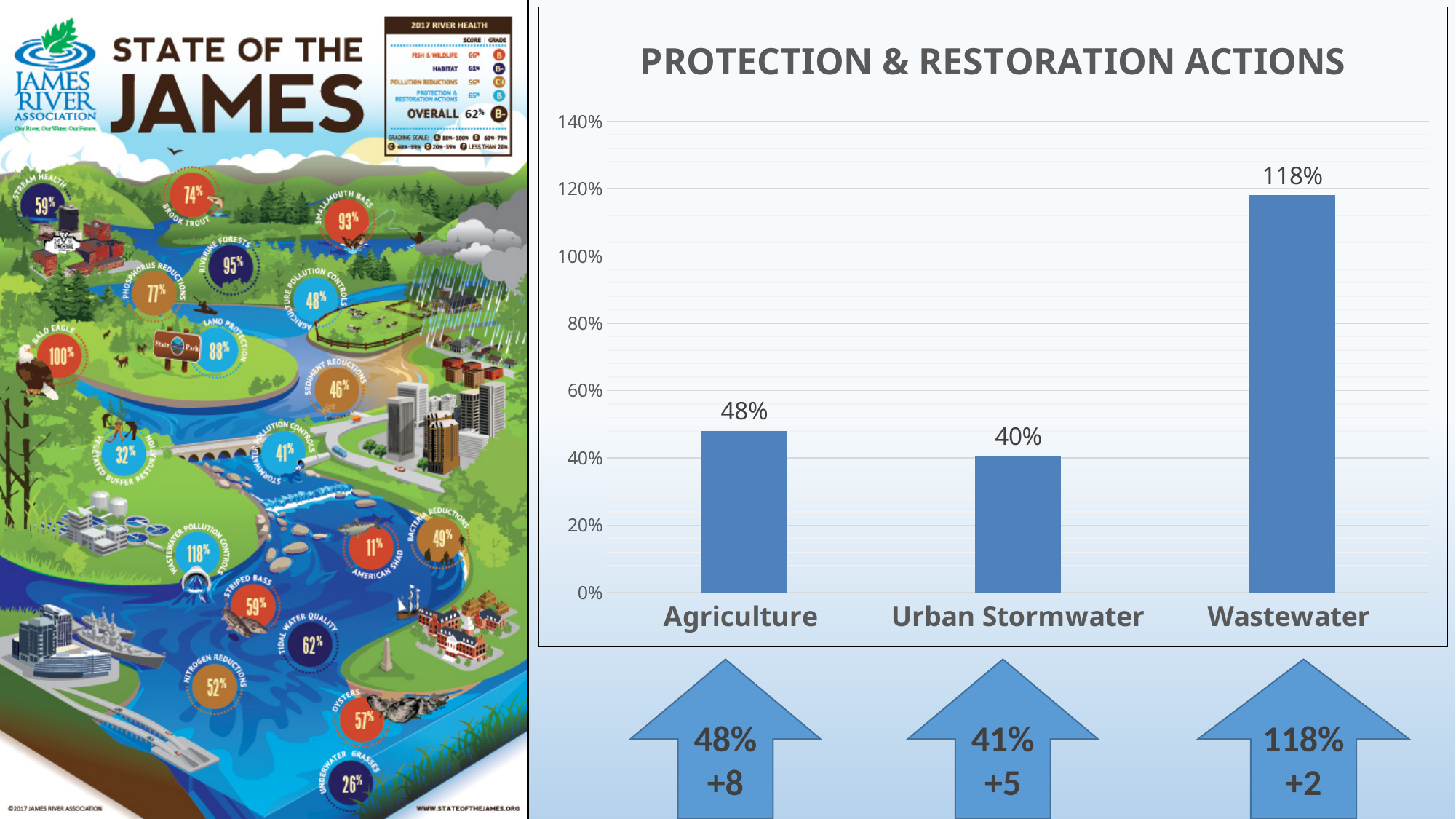
Is the value for Wastewater in the Protection & Restoration Actions chart greater or less than 100%? greater What is the value for Agriculture in the Protection & Restoration Actions chart? 48% In the Protection & Restoration Actions chart, which is larger: Agriculture or Urban Stormwater? Agriculture How many categories are shown in the Protection & Restoration Actions chart? 3 What is the value for Urban Stormwater in the Protection & Restoration Actions chart? 40% What is the difference between the Wastewater and Agriculture values in the Protection & Restoration Actions chart? 70% Which category has the lowest value in the Protection & Restoration Actions chart? Urban Stormwater What is the value for Wastewater in the Protection & Restoration Actions chart? 118% What is the difference between the Agriculture and Urban Stormwater values in the Protection & Restoration Actions chart? 8% What kind of chart is the Protection & Restoration Actions chart? Bar chart Which category has the highest value in the Protection & Restoration Actions chart? Wastewater What is the title of the bar chart on the slide? PROTECTION & RESTORATION ACTIONS